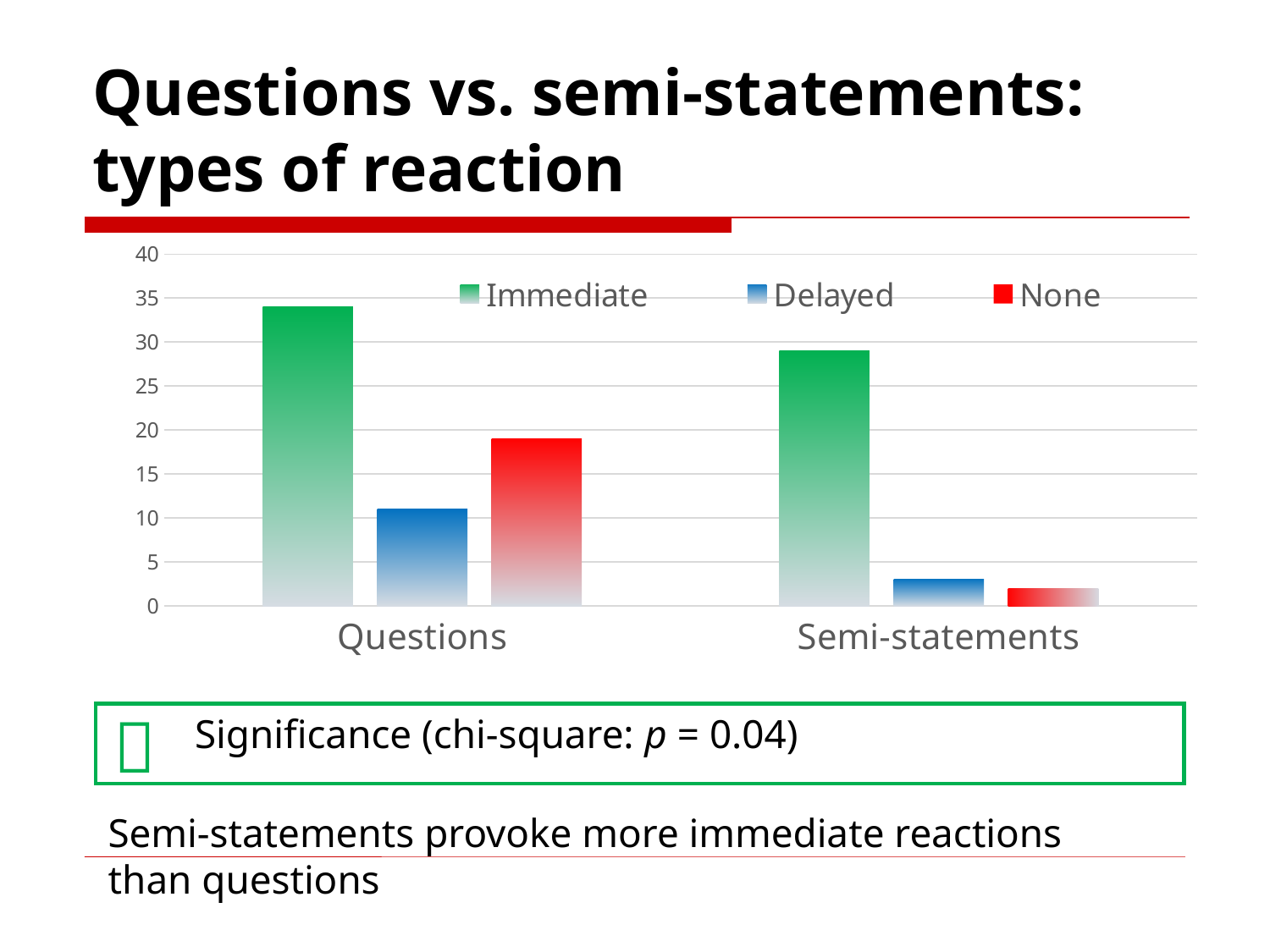
Which series has the highest value for Questions? Immediate How many series does the legend list? 3 Is the Immediate value for Questions greater or less than 30? greater How many categories are shown on the x axis? 2 Which is larger, the Immediate value for Questions or the Immediate value for Semi-statements? Questions Is the Delayed value for Questions greater or less than 15? less Which series has the lowest value for Questions? Delayed Is the Immediate value for Semi-statements greater or less than 25? greater What colour represents the None series in the legend? red What kind of chart is shown on the slide? bar chart Which series has the highest value for Semi-statements? Immediate